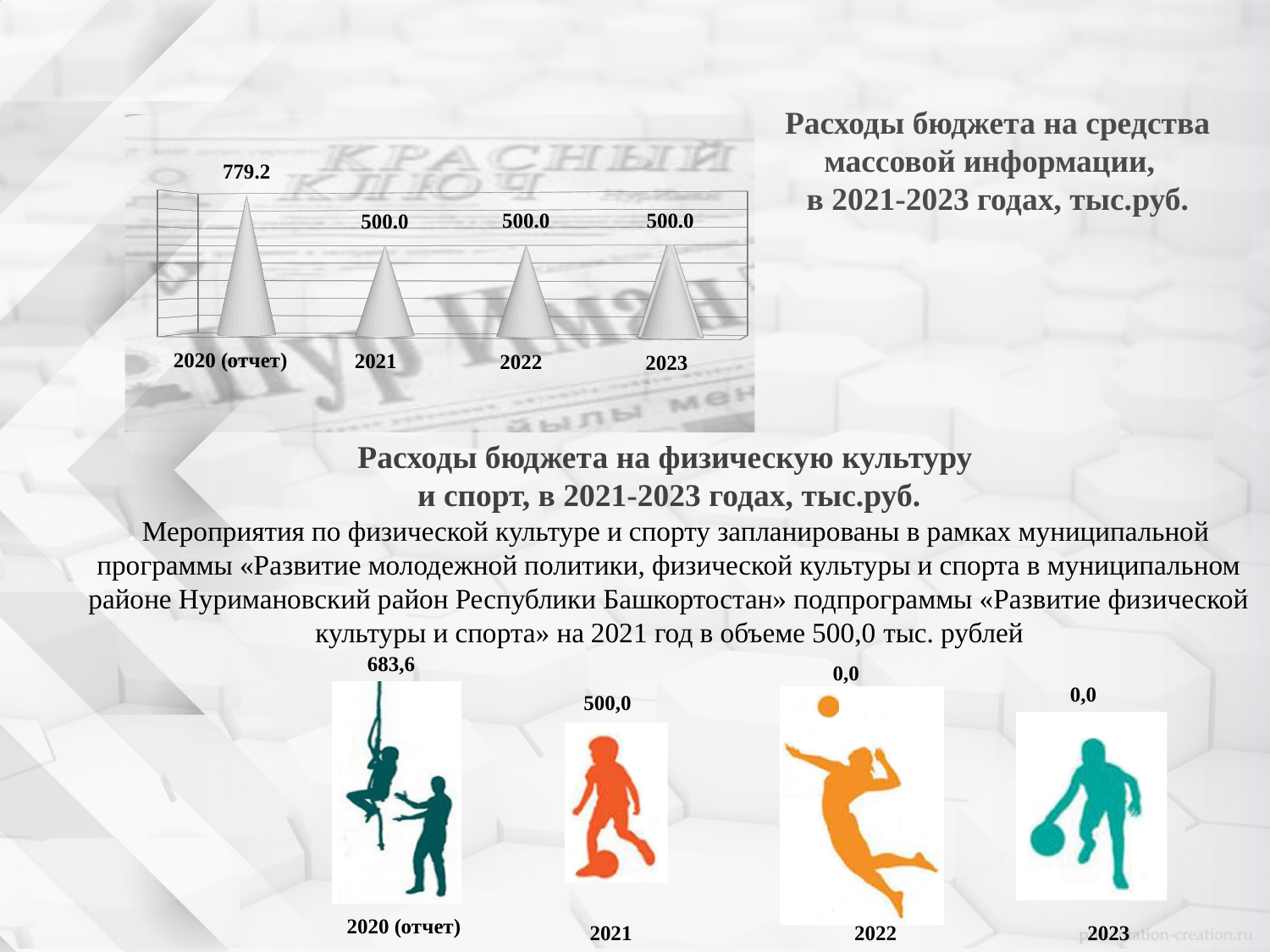
In the top chart 'Расходы бюджета на средства массовой информации', which is larger: the value for 2020 (отчет) or the value for 2022? 2020 (отчет) In the top chart 'Расходы бюджета на средства массовой информации', which year has the highest value? 2020 (отчет) In the bottom chart 'Расходы бюджета на физическую культуру и спорт', what is the value for 2020 (отчет)? 683,6 In the top chart 'Расходы бюджета на средства массовой информации', what is the difference between the values for 2020 (отчет) and 2023? 279.2 What kind of chart is the top chart 'Расходы бюджета на средства массовой информации'? bar chart In the top chart 'Расходы бюджета на средства массовой информации', how many years are shown on the x axis? 4 In the top chart 'Расходы бюджета на средства массовой информации', how many years have a value of 500.0? 3 In the bottom chart 'Расходы бюджета на физическую культуру и спорт', what is the difference between the values for 2020 (отчет) and 2021? 183,6 In the top chart 'Расходы бюджета на средства массовой информации', what is the value for 2020 (отчет)? 779.2 In the top chart 'Расходы бюджета на средства массовой информации', what is the value for 2021? 500.0 In the bottom chart 'Расходы бюджета на физическую культуру и спорт', what is the value for 2022? 0,0 In the top chart 'Расходы бюджета на средства массовой информации', do the values rise or fall from 2020 (отчет) to 2021? fall